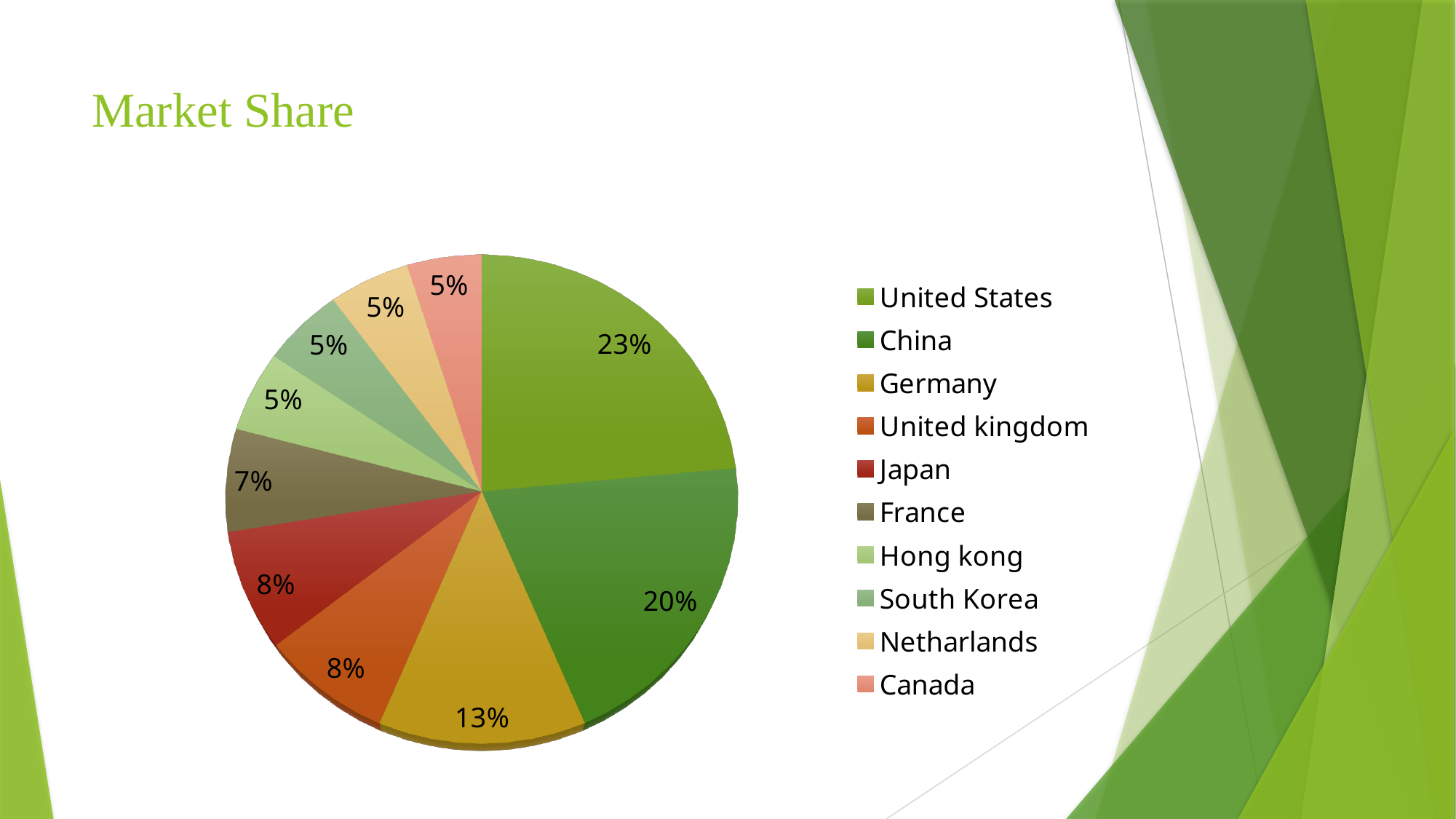
Which is larger, the share for Germany or the share for Japan? Germany What share of the pie does China hold? 20% How many countries are listed in the legend? 10 What is the title of the chart on the slide? Market Share What is the value shown for France? 7% How many countries have a share of 5%? 4 What is the combined share of the United Kingdom and Japan? 16% What share of the pie does the United States hold? 23% What is the difference between the shares of the United States and China? 3% Which country has the largest share of the pie? United States What type of chart is shown on the slide? pie chart What is the value shown for Germany? 13%